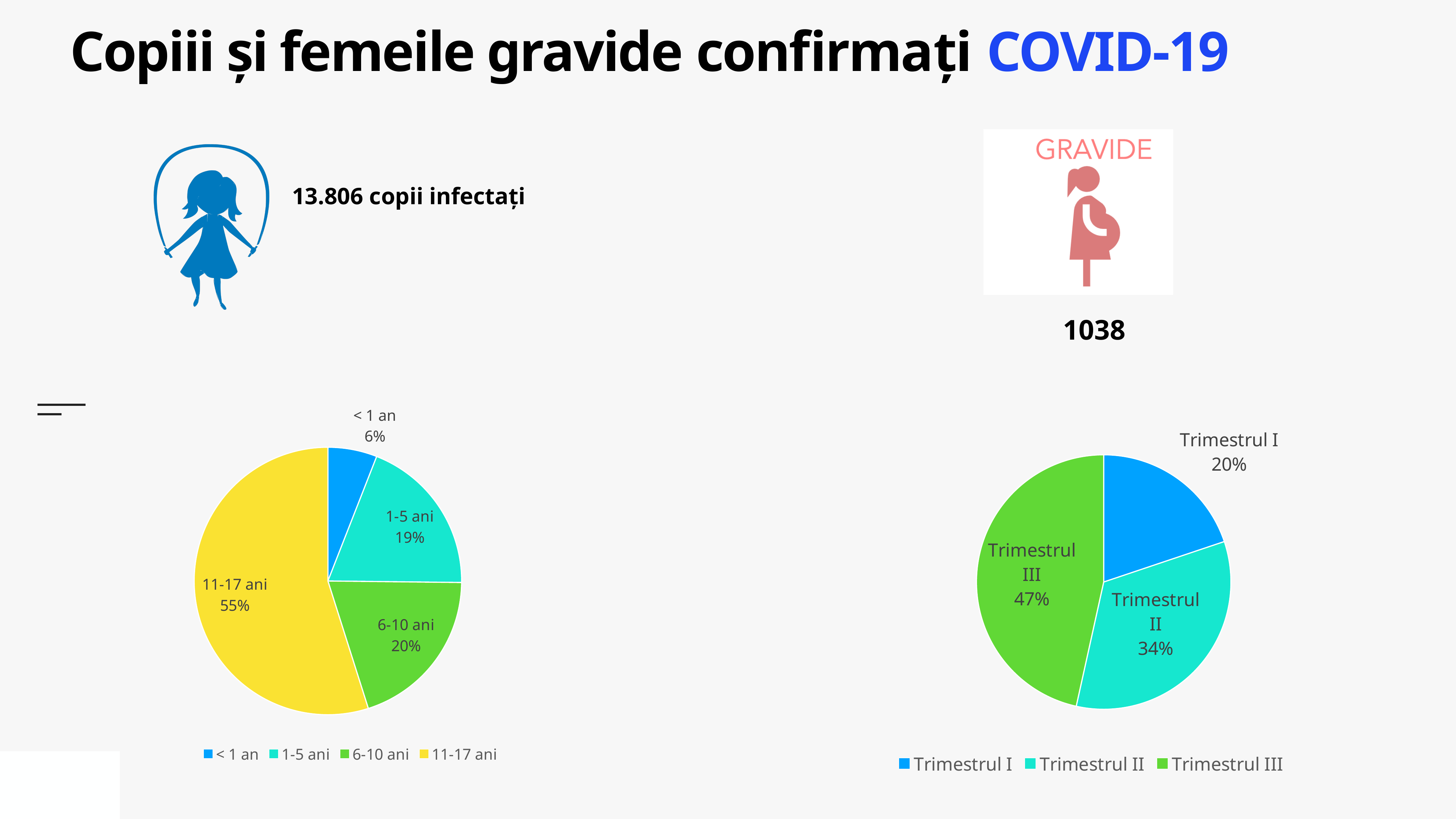
In the left pie chart (children by age group), what share is labelled for < 1 an? 6% In the right pie chart (pregnant women by trimester), which trimester has the smallest slice? Trimestrul I In the right pie chart (pregnant women by trimester), what is the difference in percentage points between Trimestrul III and Trimestrul I? 27 In the left pie chart (children by age group), what is the difference in percentage points between 11-17 ani and 1-5 ani? 36 What type of chart is used on the left side of the slide for the children's age groups? Pie chart In the left pie chart (children by age group), which age group has the largest slice? 11-17 ani In the right pie chart (pregnant women by trimester), what share is labelled for Trimestrul II? 34% In the right pie chart (pregnant women by trimester), which trimester has the largest slice? Trimestrul III In the left pie chart (children by age group), which age group has the smallest slice? < 1 an In the left pie chart (children by age group), what share is labelled for 11-17 ani? 55% In the left pie chart (children by age group), how many slices does the pie have? 4 In the right pie chart (pregnant women by trimester), how many entries does the legend list? 3